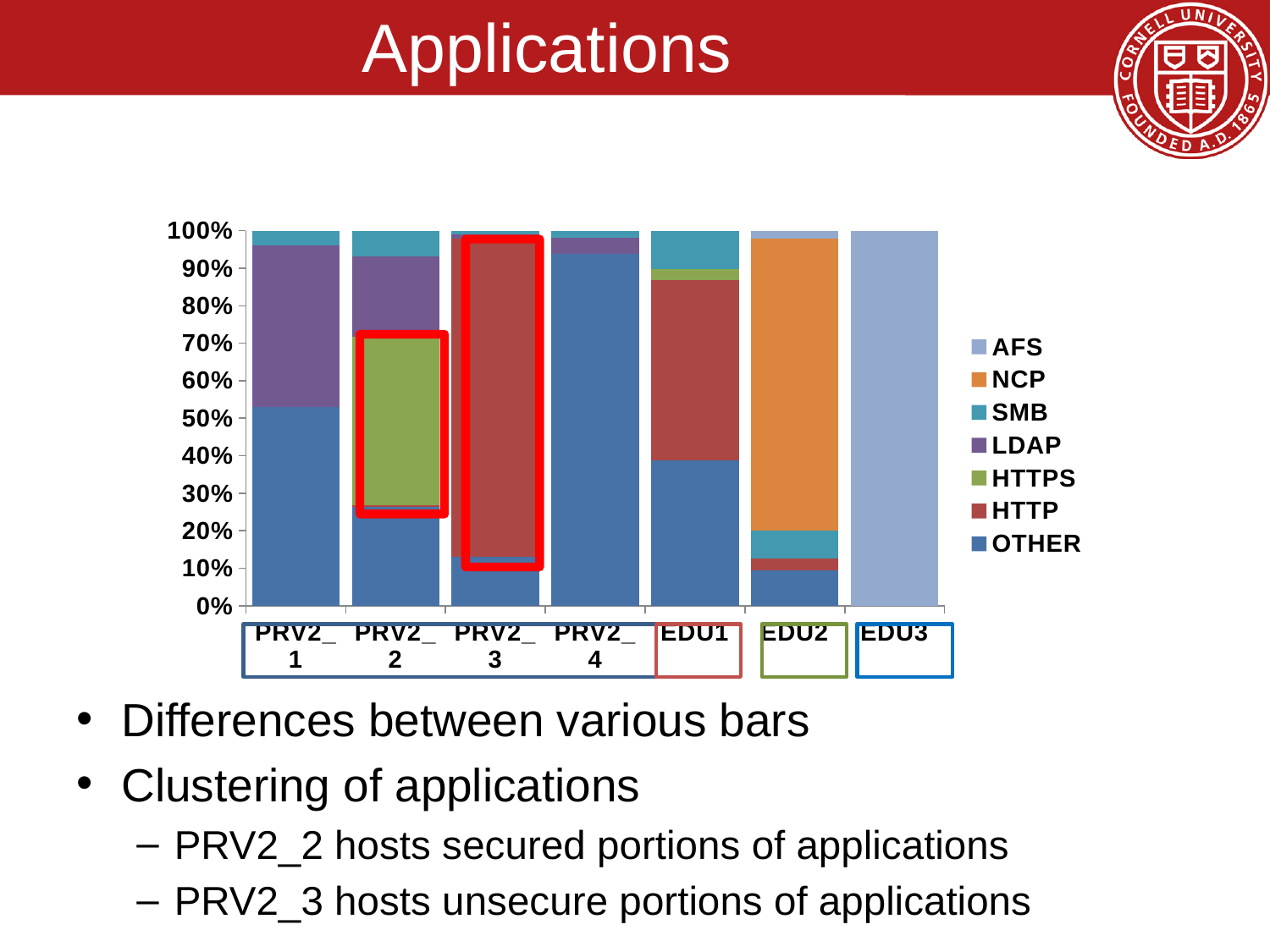
Is the HTTP share for PRV2_3 greater or less than 80%? greater What is the title of the slide containing the chart? Applications How many categories are shown along the x axis of the chart? 7 Is the NCP share for EDU2 greater or less than 70%? greater Which single application makes up the entire EDU3 bar? AFS Is the OTHER share for PRV2_3 greater or less than 20%? less How many series does the chart's legend list? 7 Which is larger, the OTHER share for PRV2_4 or for PRV2_3? PRV2_4 Which category has the largest OTHER share? PRV2_4 What kind of chart is shown on the slide? stacked bar chart Which series is listed first (at the top) in the legend? AFS